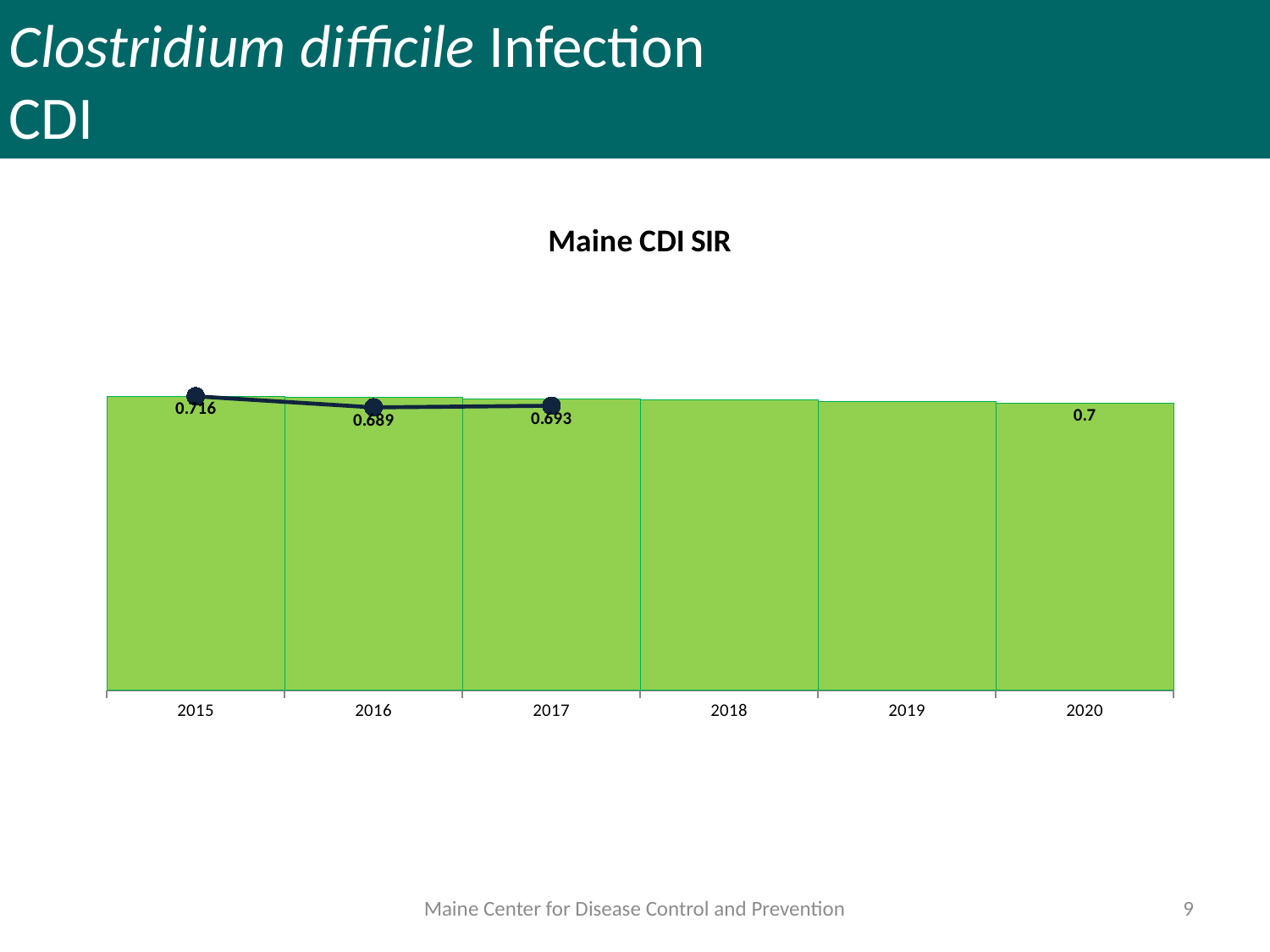
Which year has the lowest plotted SIR value on the line? 2016 What is the Maine CDI SIR value for 2015? 0.716 What is the Maine CDI SIR value for 2016? 0.689 What value is labelled at 2020 on the green area of the chart? 0.7 Which year has the highest plotted SIR value on the line? 2015 What is the Maine CDI SIR value for 2017? 0.693 Which year has the larger SIR value, 2016 or 2017? 2017 What is the title of the chart? Maine CDI SIR How many years are shown on the x axis of the chart? 6 What is the difference between the SIR values for 2015 and 2016? 0.027 What is the difference between the SIR values for 2017 and 2016? 0.004 Does the SIR value rise or fall from 2015 to 2016? fall